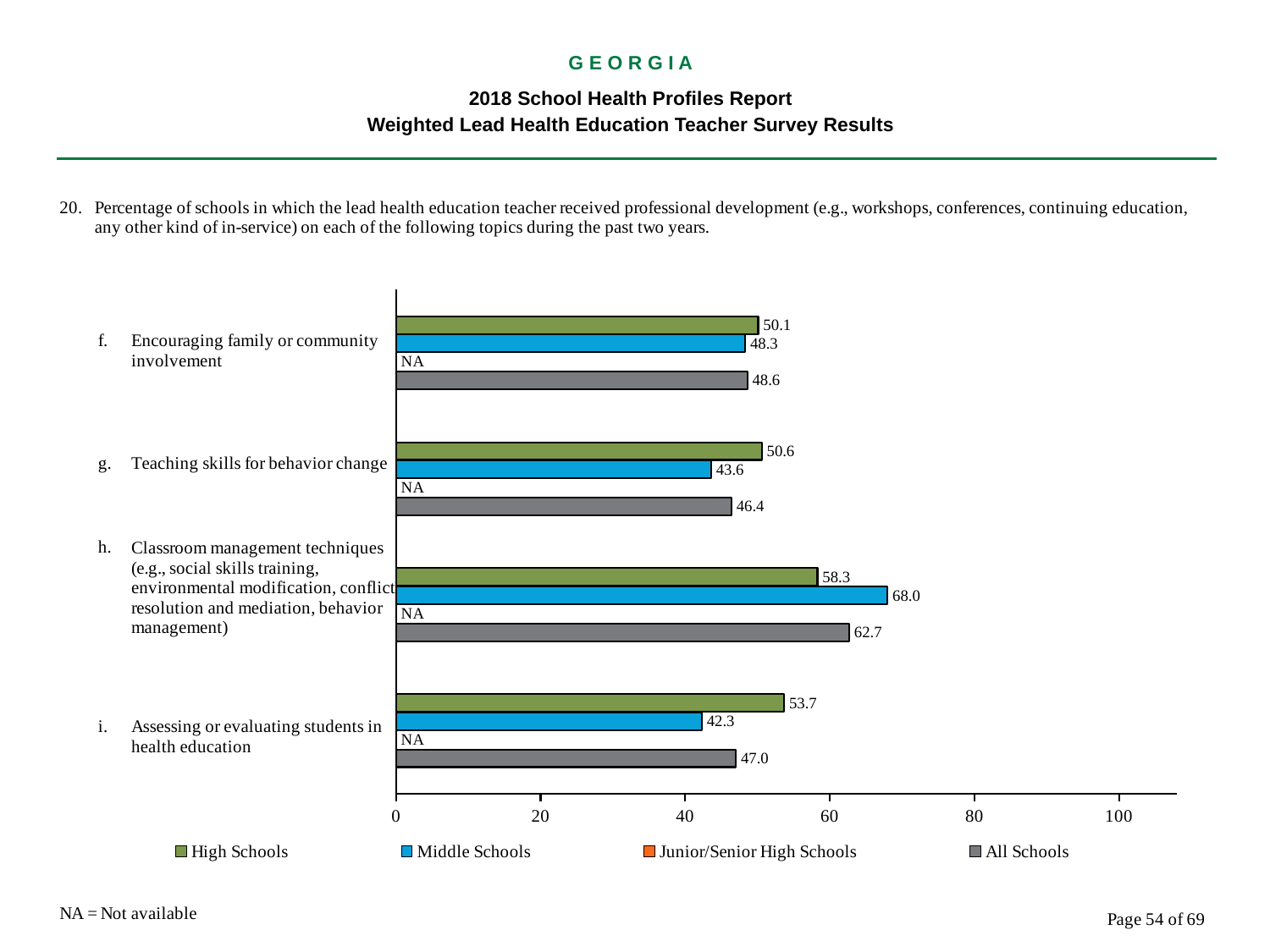
What is the Middle Schools value for 'Classroom management techniques'? 68.0 Which topic has the highest All Schools value? Classroom management techniques For 'Assessing or evaluating students in health education', which is larger: the High Schools value or the Middle Schools value? High Schools What is the Middle Schools value for 'Teaching skills for behavior change'? 43.6 Which topic has the lowest Middle Schools value? Assessing or evaluating students in health education What is the difference between the Middle Schools and High Schools values for 'Classroom management techniques'? 9.7 What is the All Schools value for 'Assessing or evaluating students in health education'? 47.0 Is the All Schools value for 'Classroom management techniques' greater or less than 60? greater What kind of chart is shown on the slide? Bar chart How many topics are shown on the chart? 4 What is the High Schools value for 'Encouraging family or community involvement'? 50.1 How many series does the legend list? 4